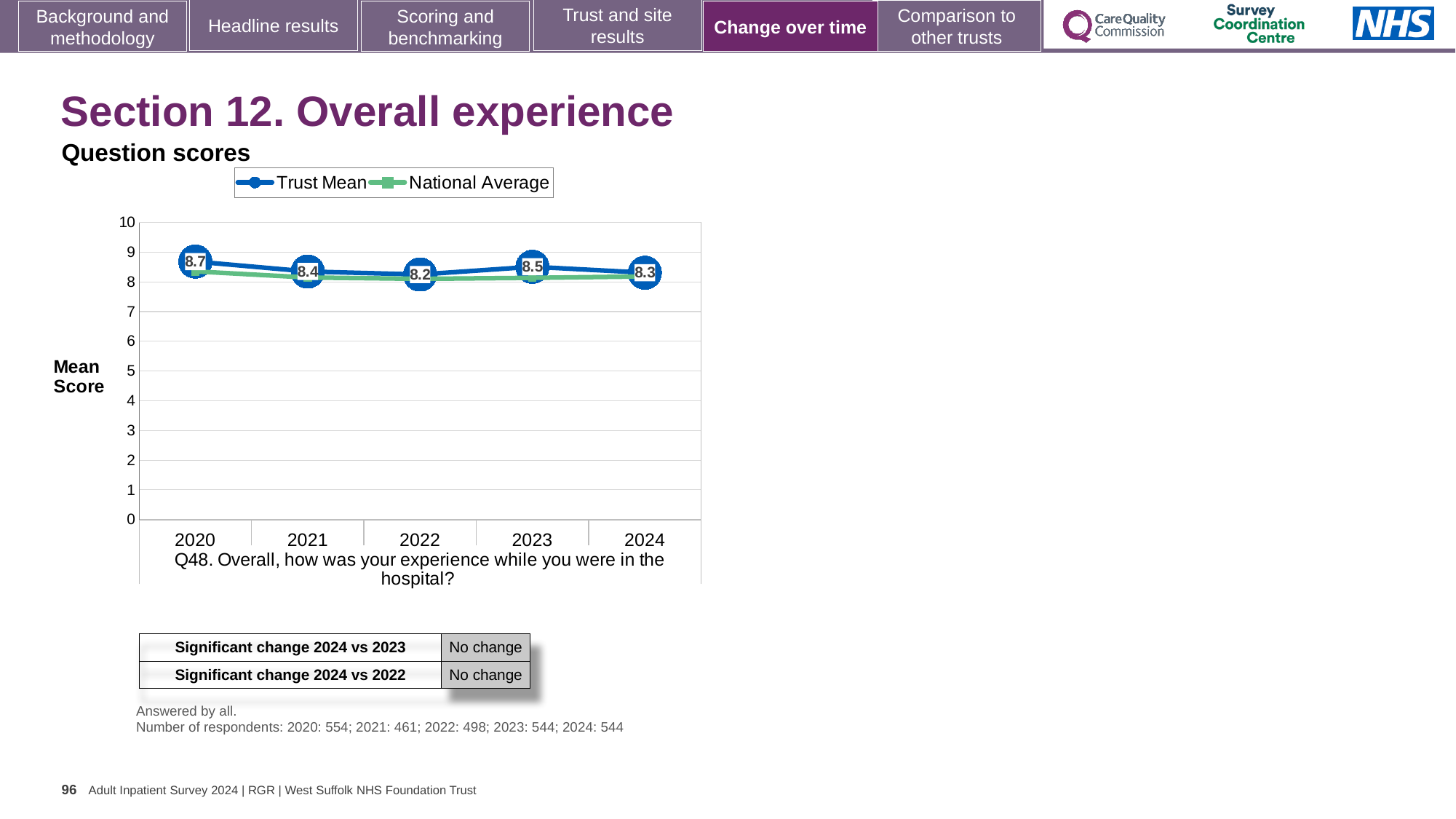
Does the Trust Mean rise or fall from 2020 to 2022? Fall Which year has the larger Trust Mean, 2021 or 2023? 2023 What is the Trust Mean score for 2022? 8.2 What is the difference between the Trust Mean in 2020 and in 2024? 0.4 In which year is the Trust Mean highest? 2020 In which year is the Trust Mean lowest? 2022 How many years are plotted on the x axis? 5 How many series does the legend list? 2 Is the National Average value for 2022 greater or less than 9? less What is the Trust Mean score for 2020? 8.7 What kind of chart is shown? Line chart What is the Trust Mean score for 2024? 8.3